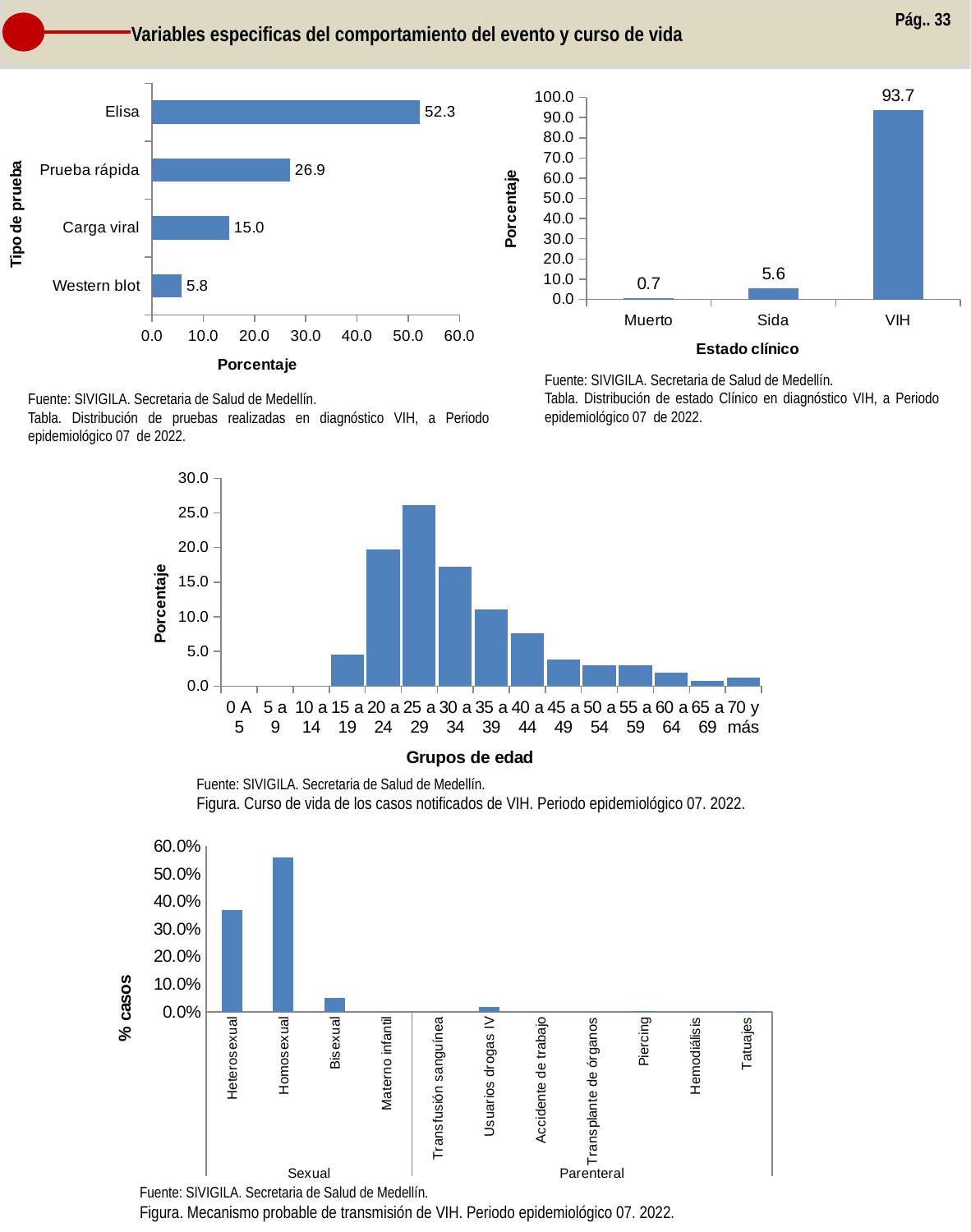
In the top-right chart (Estado clínico), what is the difference between VIH and Muerto? 93.0 In the top-left chart (Tipo de prueba), how many test types are shown? 4 In the middle chart (Grupos de edad), which age group has the highest percentage? 25 a 29 In the top-left chart (Tipo de prueba), what is the value for Carga viral? 15.0 In the top-right chart (Estado clínico), what is the value for Sida? 5.6 In the top-right chart (Estado clínico), which clinical state has the highest percentage? VIH In the top-left chart (Tipo de prueba), what is the value for Elisa? 52.3 In the bottom chart (% casos), is the value for Homosexual greater or less than 50.0%? greater In the top-left chart (Tipo de prueba), what is the difference between Elisa and Prueba rápida? 25.4 In the middle chart (Grupos de edad), is the value for 20 a 24 greater or less than 15.0? greater In the bottom chart (% casos), which of Heterosexual or Homosexual has the larger value? Homosexual In the top-left chart (Tipo de prueba), which test type has the lowest percentage? Western blot